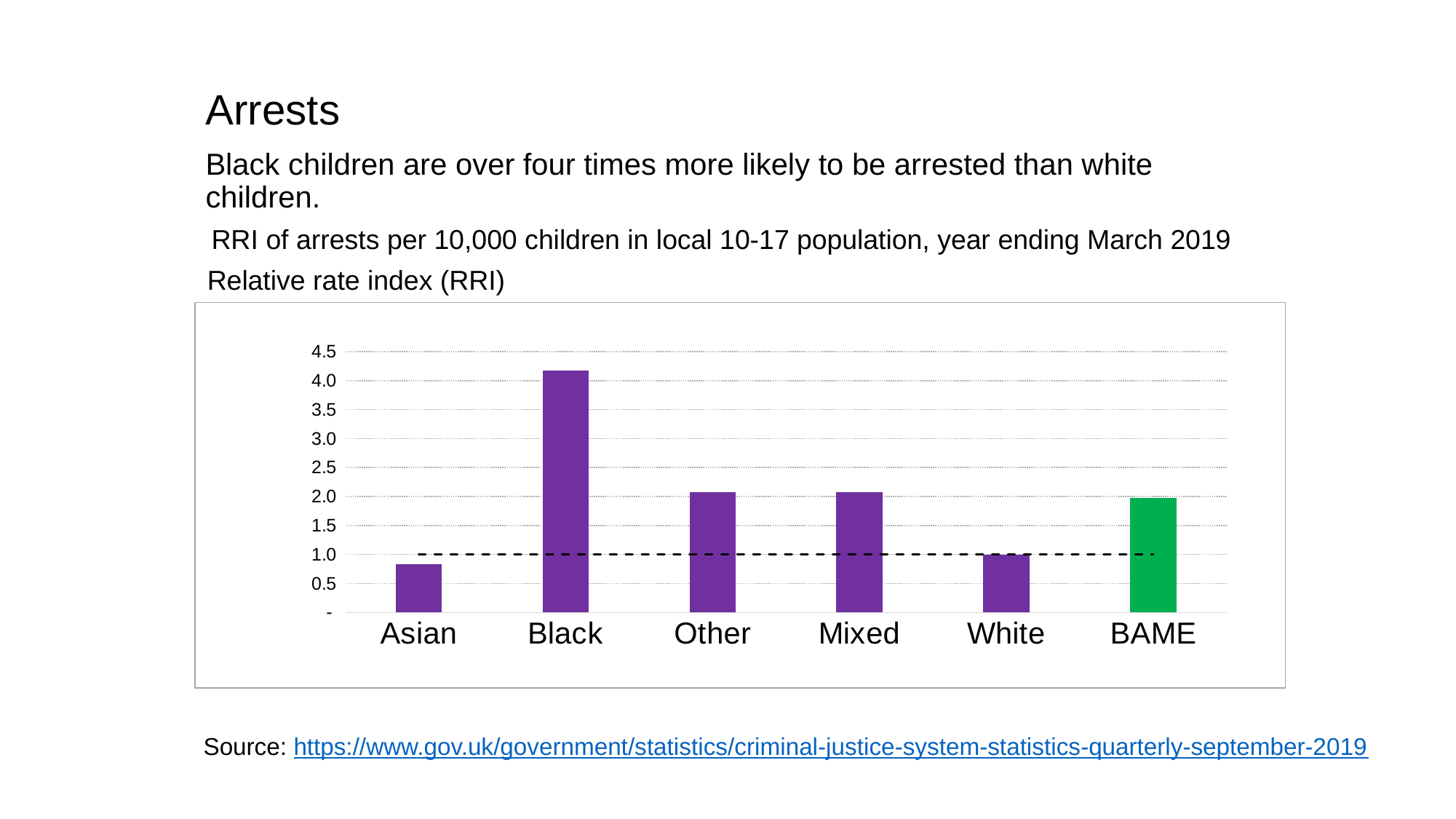
Which has a larger relative rate index, Black or Other? Black What kind of chart is shown on the slide? Bar chart At what value on the y axis is the horizontal dashed line drawn? 1.0 Which category has the lowest relative rate index in the chart? Asian Is the value for BAME greater or less than 1.5? greater Which bar in the chart is coloured green rather than purple? BAME Is the value for White greater or less than 1.5? less Is the value for Other greater or less than 1.5? greater Which category has the highest relative rate index in the chart? Black How many categories are shown on the x axis of the chart? 6